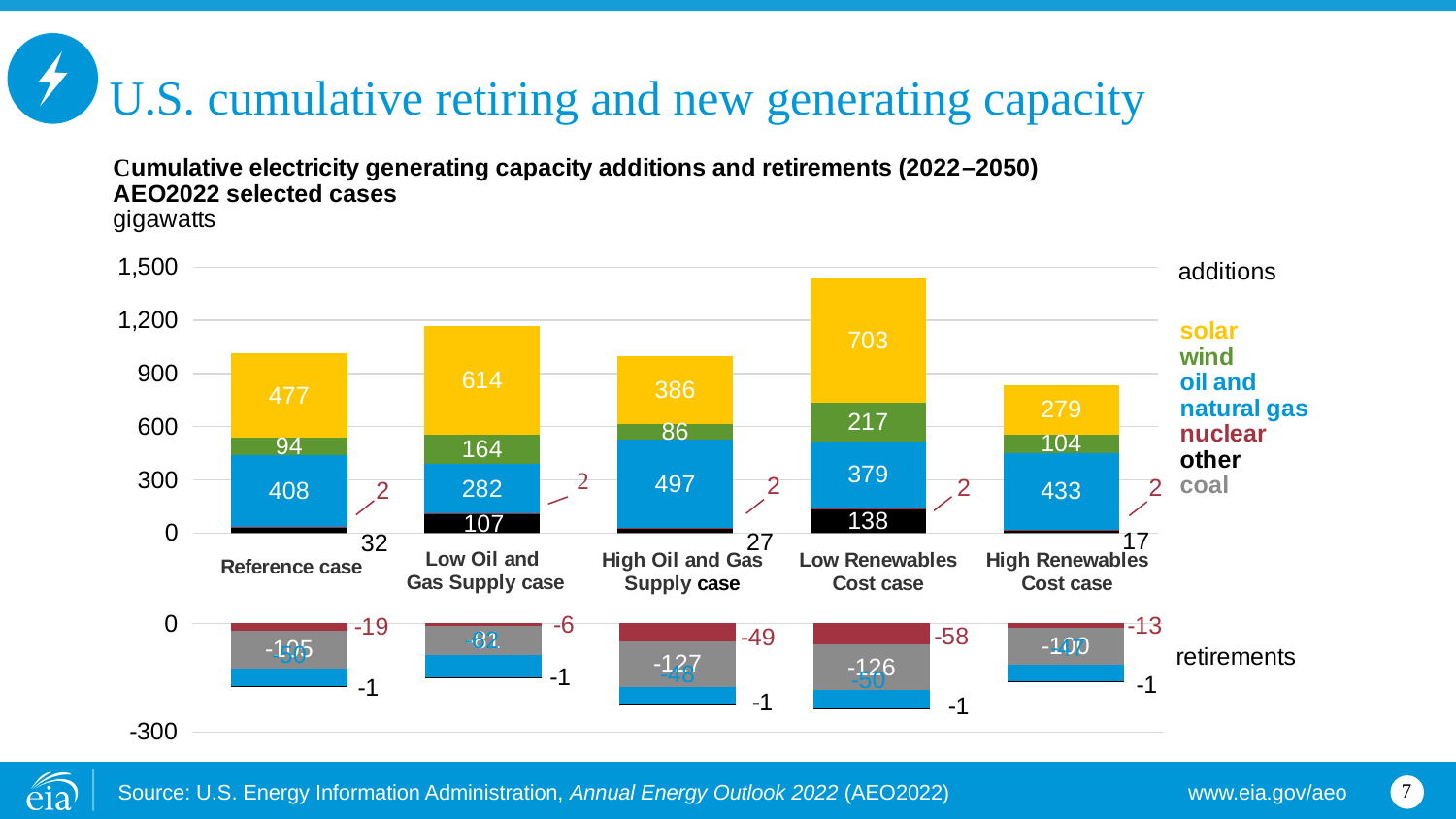
What kind of chart is shown? stacked bar chart Which case has larger wind additions, the Low Renewables Cost case or the High Renewables Cost case? Low Renewables Cost case What is the solar addition value for the Low Renewables Cost case? 703 What is the difference between solar additions in the Low Oil and Gas Supply case and the Reference case? 137 Is the total additions bar for the Low Renewables Cost case greater or less than 1,200? greater What is the oil and natural gas addition value for the High Oil and Gas Supply case? 497 How many fuel categories does the legend list? 6 What is the wind addition value for the Reference case? 94 What is the nuclear retirement value for the Low Renewables Cost case? -58 How many cases are shown on the x axis? 5 Which case has the lowest solar additions? High Renewables Cost case Which case has the highest solar additions? Low Renewables Cost case